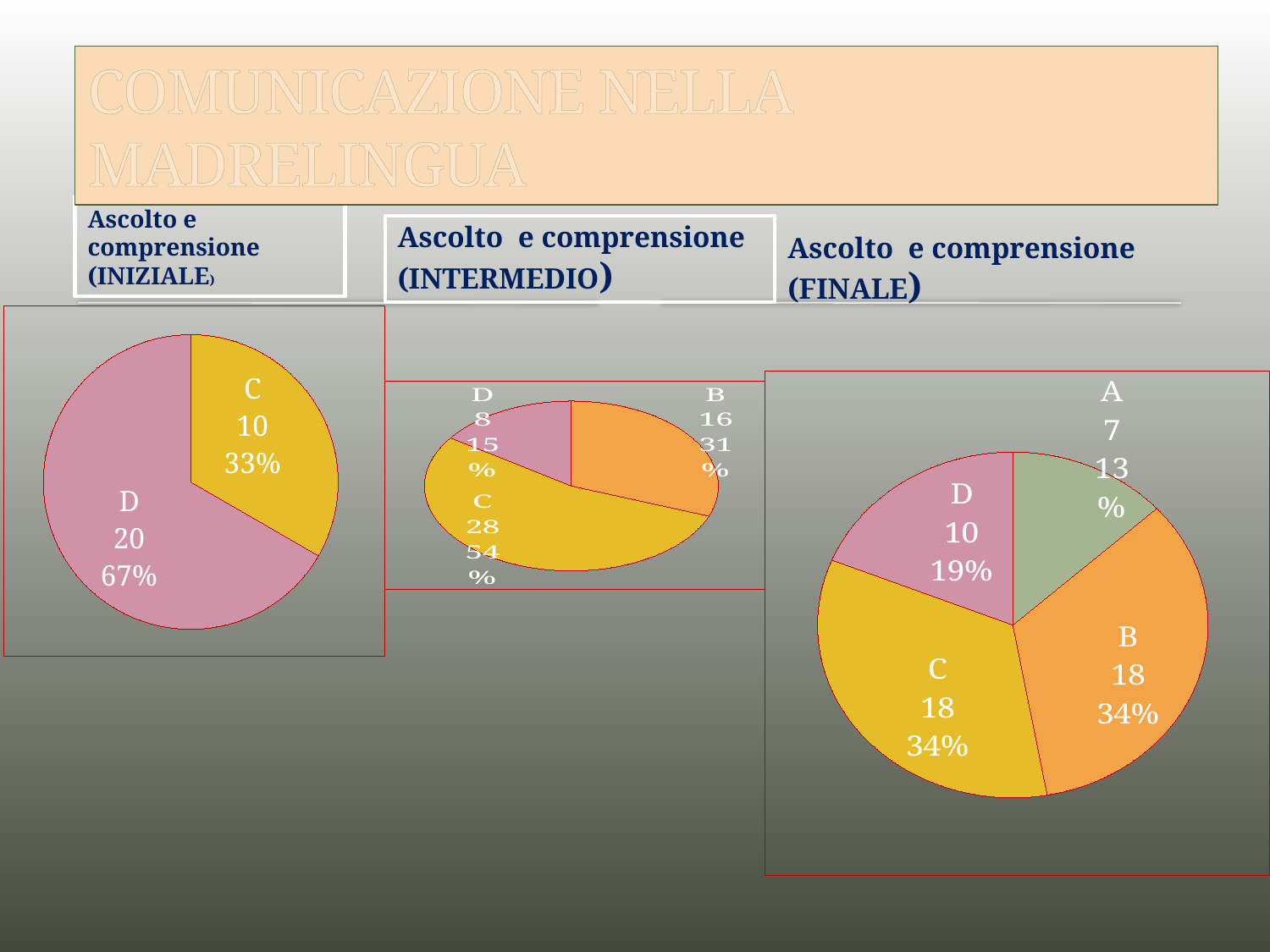
How many slices does the 'Ascolto e comprensione (FINALE)' pie chart have? 4 In the 'Ascolto e comprensione (INTERMEDIO)' chart, what share of the pie does B have? 31% In the 'Ascolto e comprensione (INTERMEDIO)' chart, which category has the smallest slice? D In the 'Ascolto e comprensione (INIZIALE)' chart, what share of the pie does C have? 33% What kind of chart is used for 'Ascolto e comprensione (INIZIALE)'? pie chart In the 'Ascolto e comprensione (FINALE)' chart, what is the value for A? 7 In the 'Ascolto e comprensione (INTERMEDIO)' chart, what is the difference between the values for C and B? 12 In the 'Ascolto e comprensione (FINALE)' chart, which category has the smallest slice? A In the 'Ascolto e comprensione (INIZIALE)' chart, what is the value for D? 20 In the 'Ascolto e comprensione (FINALE)' chart, which is larger, the value for D or the value for A? D How many slices does the 'Ascolto e comprensione (INIZIALE)' pie chart have? 2 In the 'Ascolto e comprensione (INTERMEDIO)' chart, what is the value for C? 28